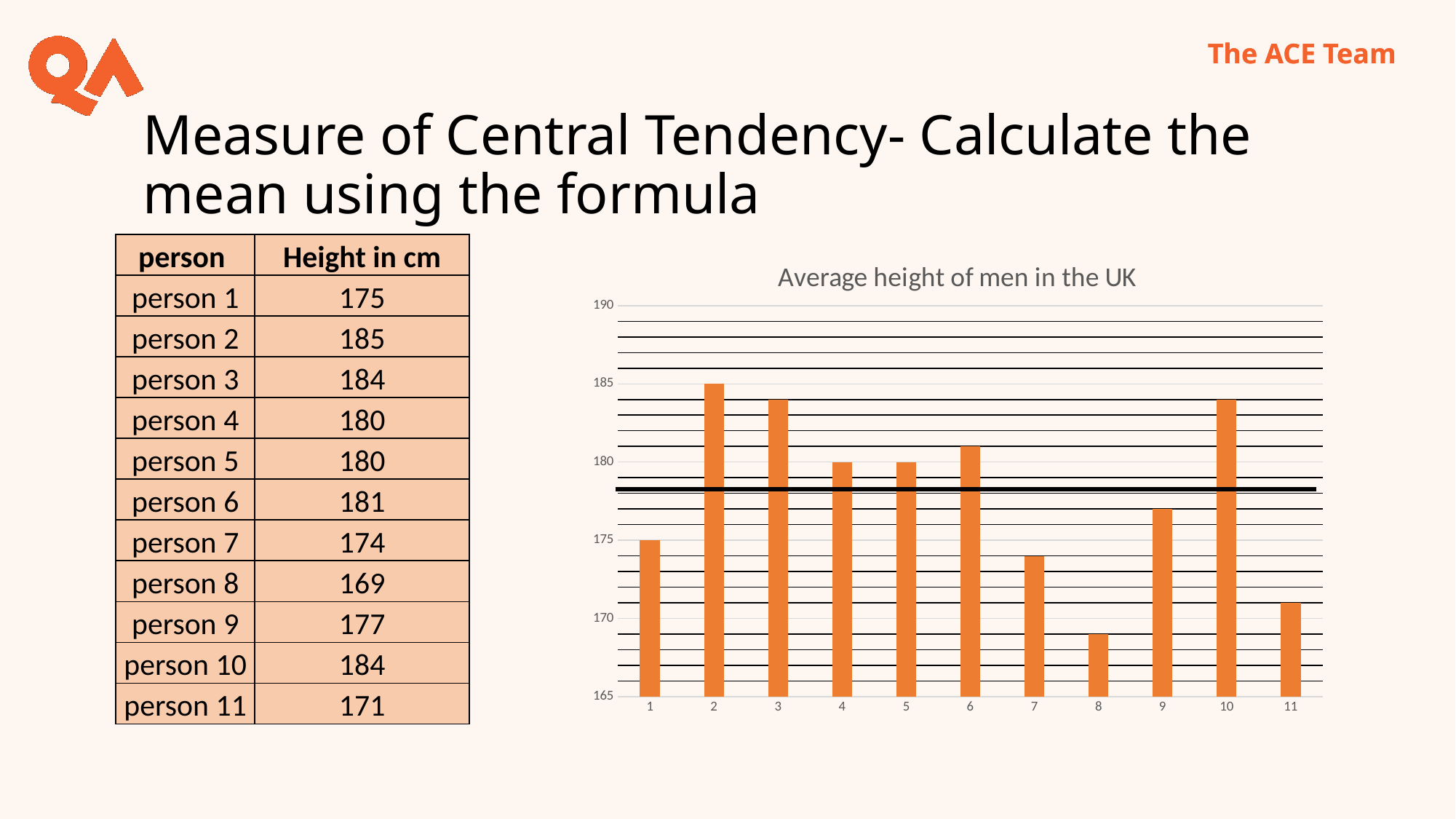
Is the value for person 7 greater or less than 175? less What is the title of the chart? Average height of men in the UK What is the difference in height between person 2 and person 8? 16 Is the value for person 6 greater or less than 180? greater What kind of chart is shown on the slide? bar chart What is the height in cm for person 8? 169 Which is taller, person 9 or person 11? person 9 What is the height in cm for person 1? 175 What is the lowest value shown on the vertical axis of the chart? 165 How many bars are plotted in the chart? 11 Which person has the lowest height in the chart? person 8 Which person has the greatest height in the chart? person 2